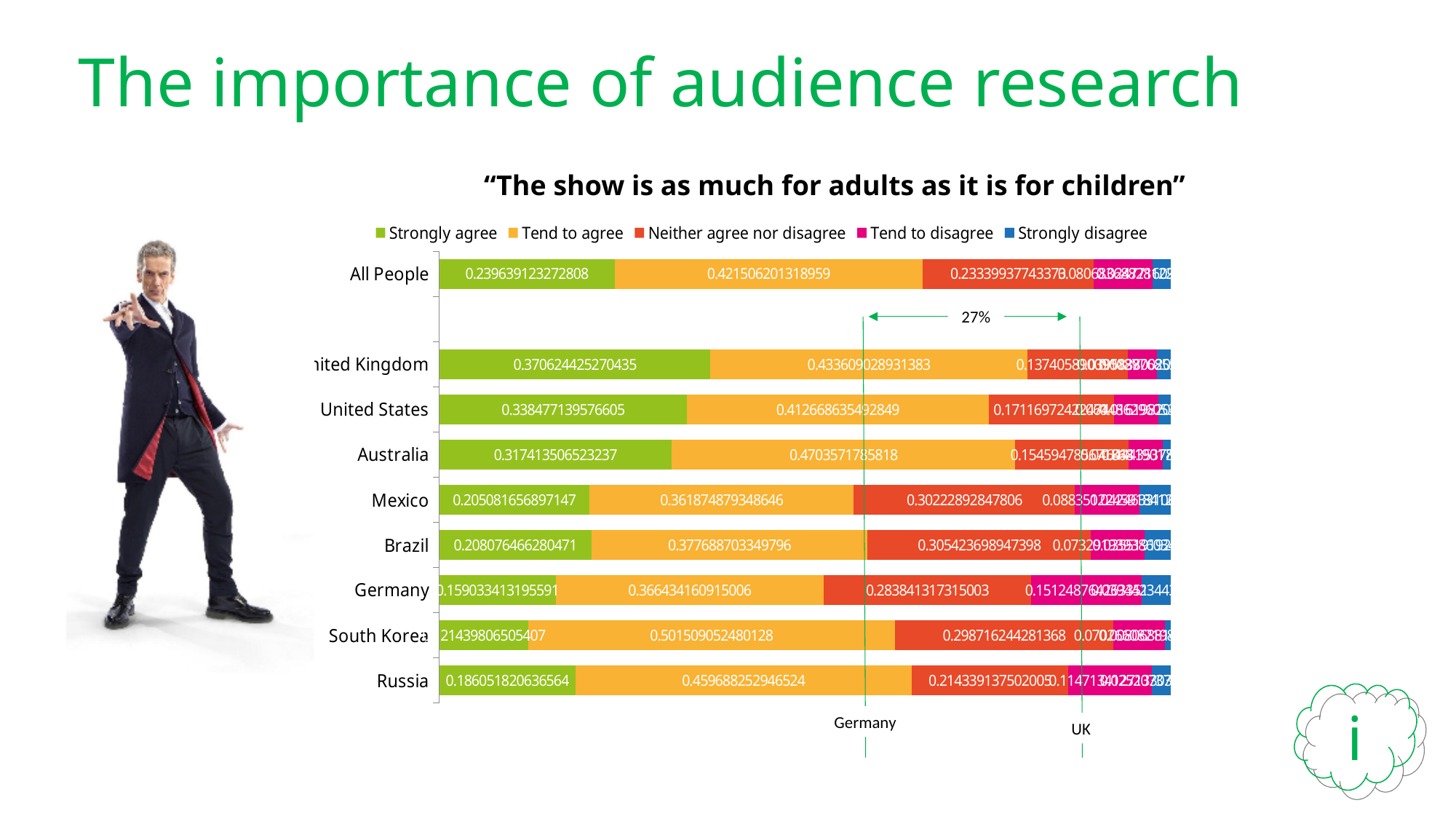
How many countries/categories are plotted on the chart? 9 Which has the larger 'Strongly agree' value, the United States or Russia? United States Which country has the highest 'Tend to agree' value? South Korea What is the 'Tend to agree' value for South Korea? 0.501509052480128 What is the 'Strongly agree' value for All People? 0.239639123272808 What is the 'Neither agree nor disagree' value for Mexico? 0.30222892847806 Which country has the highest 'Strongly agree' value? United Kingdom How many series does the chart legend list? 5 What is the 'Strongly agree' value for the United Kingdom? 0.370624425270435 What kind of chart is shown on the slide? Stacked bar chart Which country has the lowest 'Strongly agree' value? South Korea What is the title of the chart? "The show is as much for adults as it is for children"